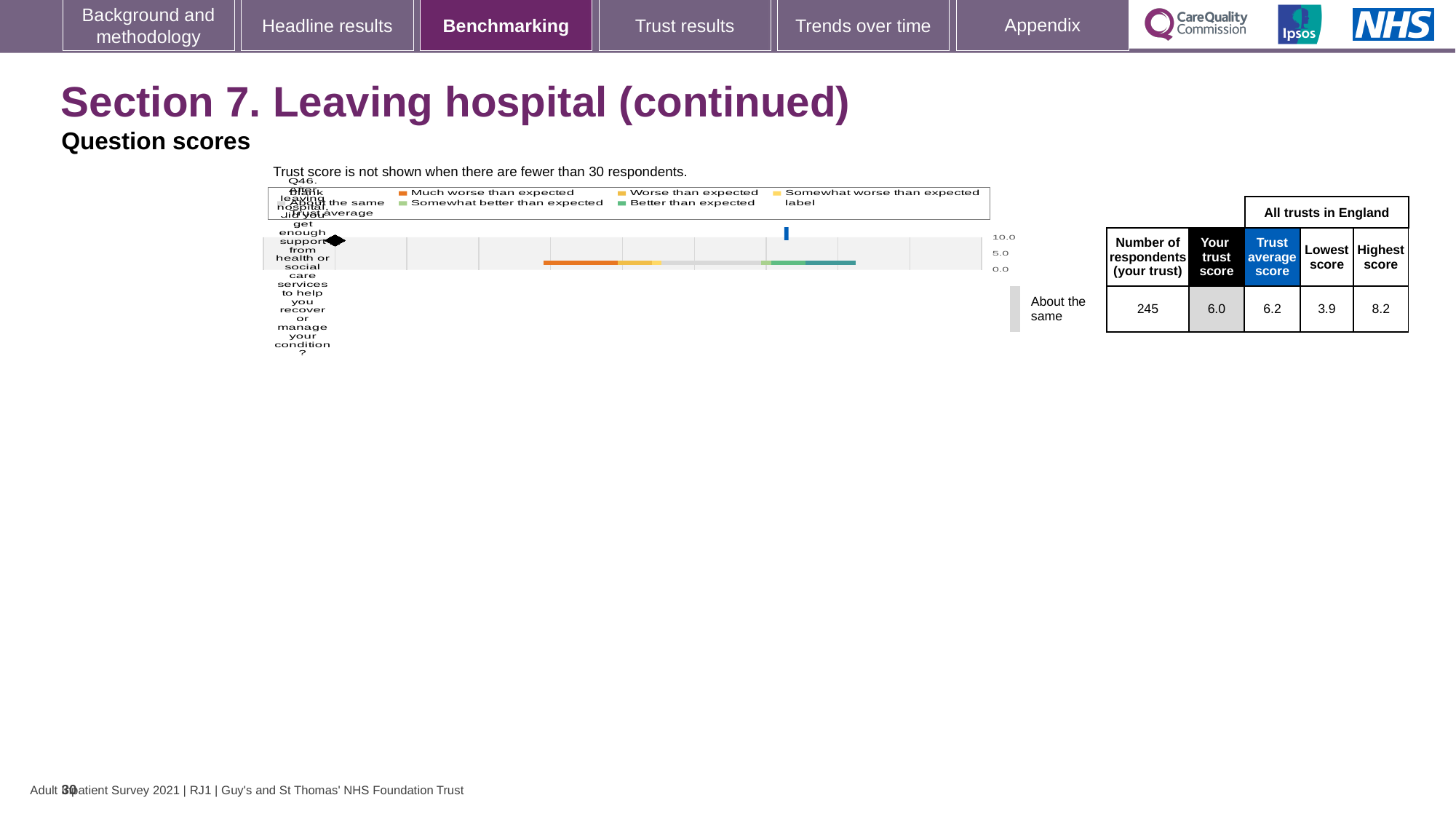
What is the difference between the highest and lowest scores for Q46 across all trusts in England? 4.3 How many respondents from the trust answered Q46? 245 What is the highest score among all trusts in England for Q46? 8.2 What type of chart is used to show the Q46 benchmarking result? Bar chart Which is larger for Q46: the trust's score or the trust average score? Trust average score What is the maximum value shown on the chart's score axis? 10.0 What is the trust score for Q46 shown in the table next to the chart? 6.0 What is the trust average score for Q46 across all trusts in England? 6.2 Is the trust's Q46 score greater or less than 5.0 on the chart axis? greater How many questions are plotted on the benchmarking chart? 1 Which benchmarking category is the trust's Q46 score placed in? About the same What is the lowest score among all trusts in England for Q46? 3.9